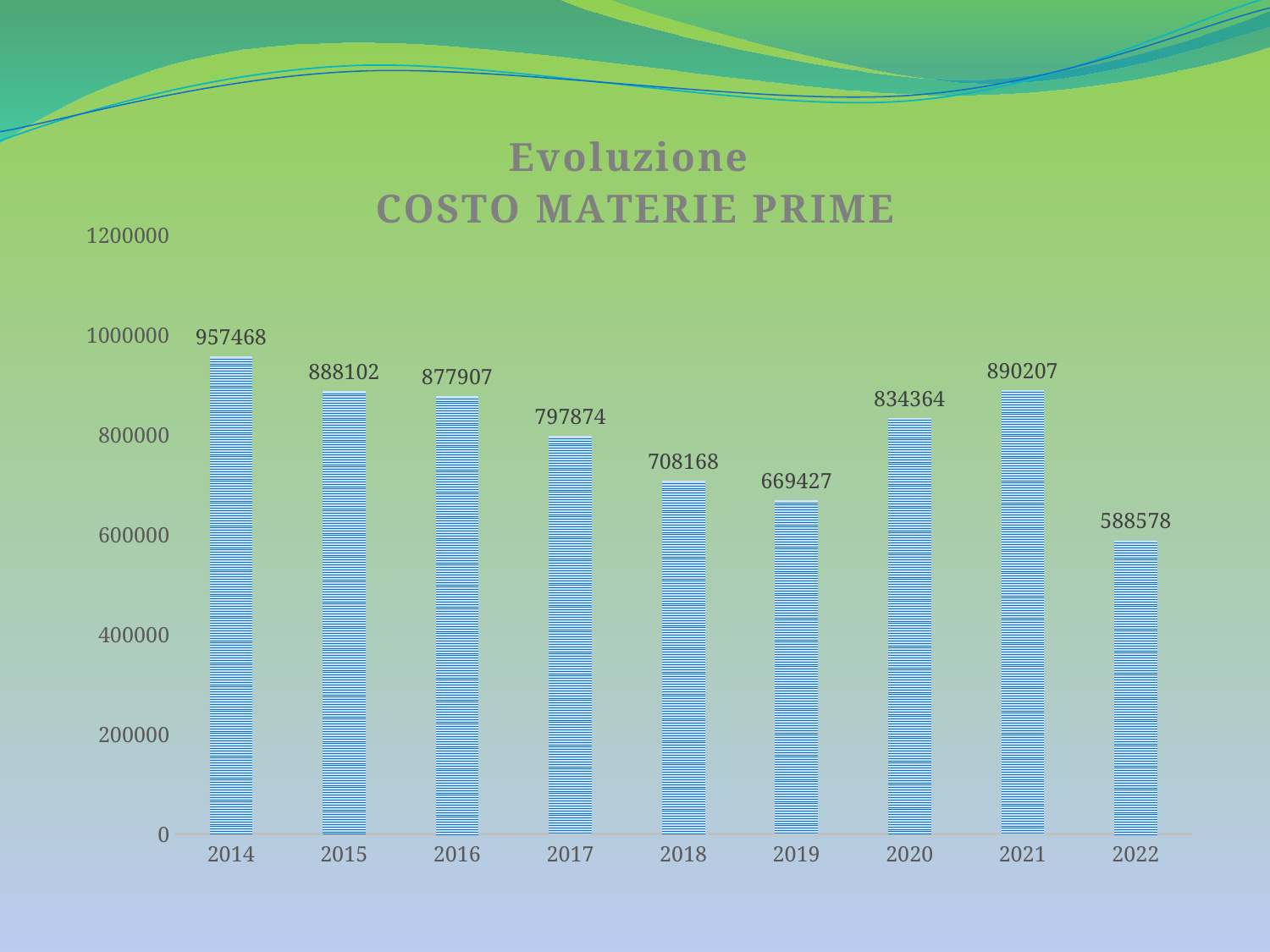
Is the value for 2020 greater or less than 800000? greater What is the value for 2022? 588578 What is the value for 2019? 669427 What kind of chart is this? bar chart Which year has the highest value? 2014 How many years are shown on the x axis? 9 What is the value for 2014? 957468 What is the title of the chart? Evoluzione COSTO MATERIE PRIME Which is larger, the value for 2017 or the value for 2018? 2017 What is the difference between the values for 2020 and 2021? 55843 Which year has the lowest value? 2022 What is the difference between the values for 2014 and 2022? 368890